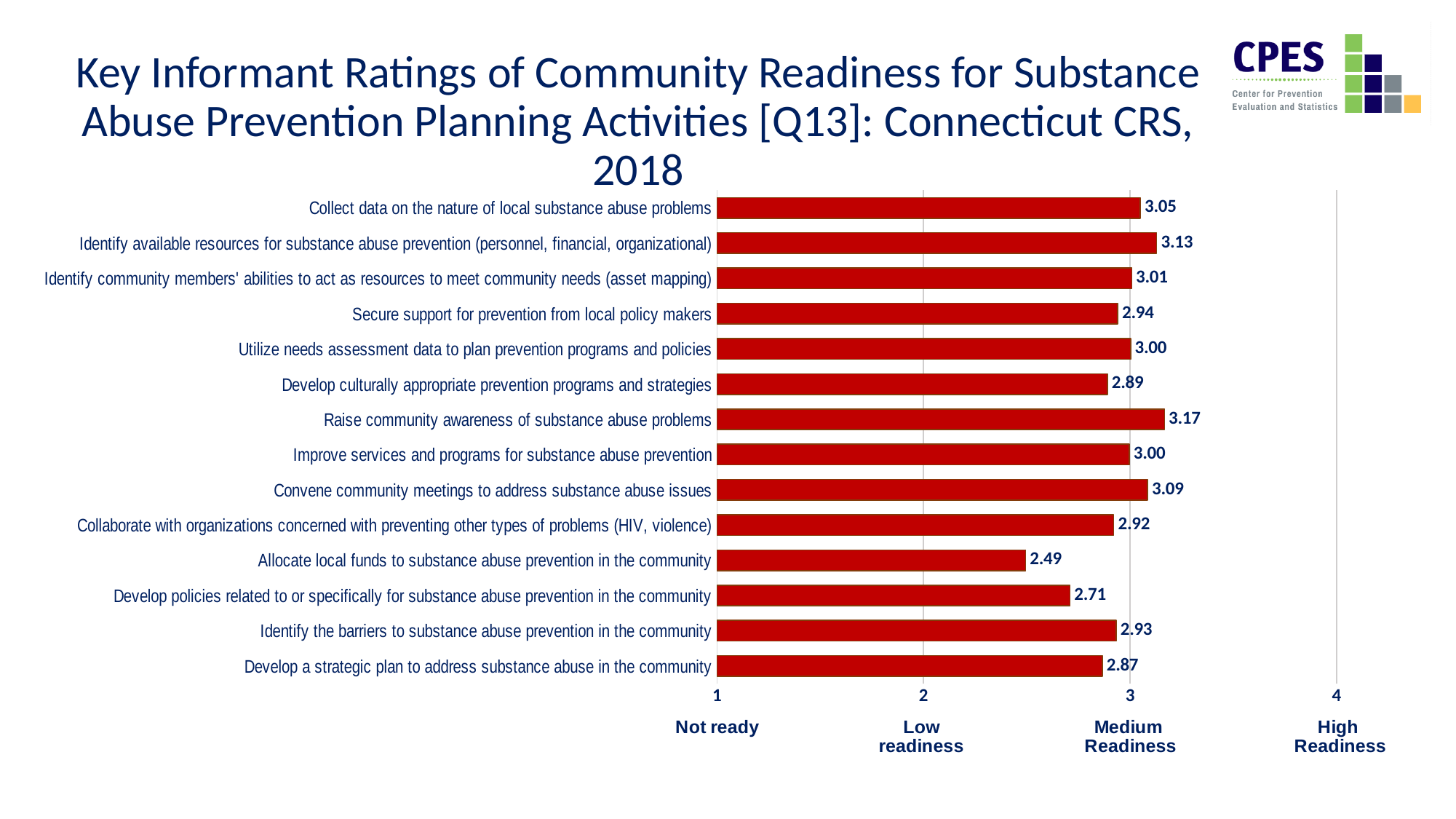
Which activity has the highest rating? Raise community awareness of substance abuse problems What is the rating for "Raise community awareness of substance abuse problems"? 3.17 Is the rating for "Develop policies related to or specifically for substance abuse prevention in the community" greater or less than 3? less Which has a higher rating: "Identify available resources for substance abuse prevention (personnel, financial, organizational)" or "Secure support for prevention from local policy makers"? Identify available resources for substance abuse prevention (personnel, financial, organizational) Which activity has the lowest rating? Allocate local funds to substance abuse prevention in the community What is the rating for "Develop a strategic plan to address substance abuse in the community"? 2.87 What is the difference between the highest rating (3.17) and the lowest rating (2.49)? 0.68 What kind of chart is shown on the slide? Bar chart How many activities are plotted in the chart? 14 What is the difference between the ratings for "Convene community meetings to address substance abuse issues" and "Collaborate with organizations concerned with preventing other types of problems (HIV, violence)"? 0.17 What label does the x axis show at the value 4? High Readiness What is the rating for "Allocate local funds to substance abuse prevention in the community"? 2.49